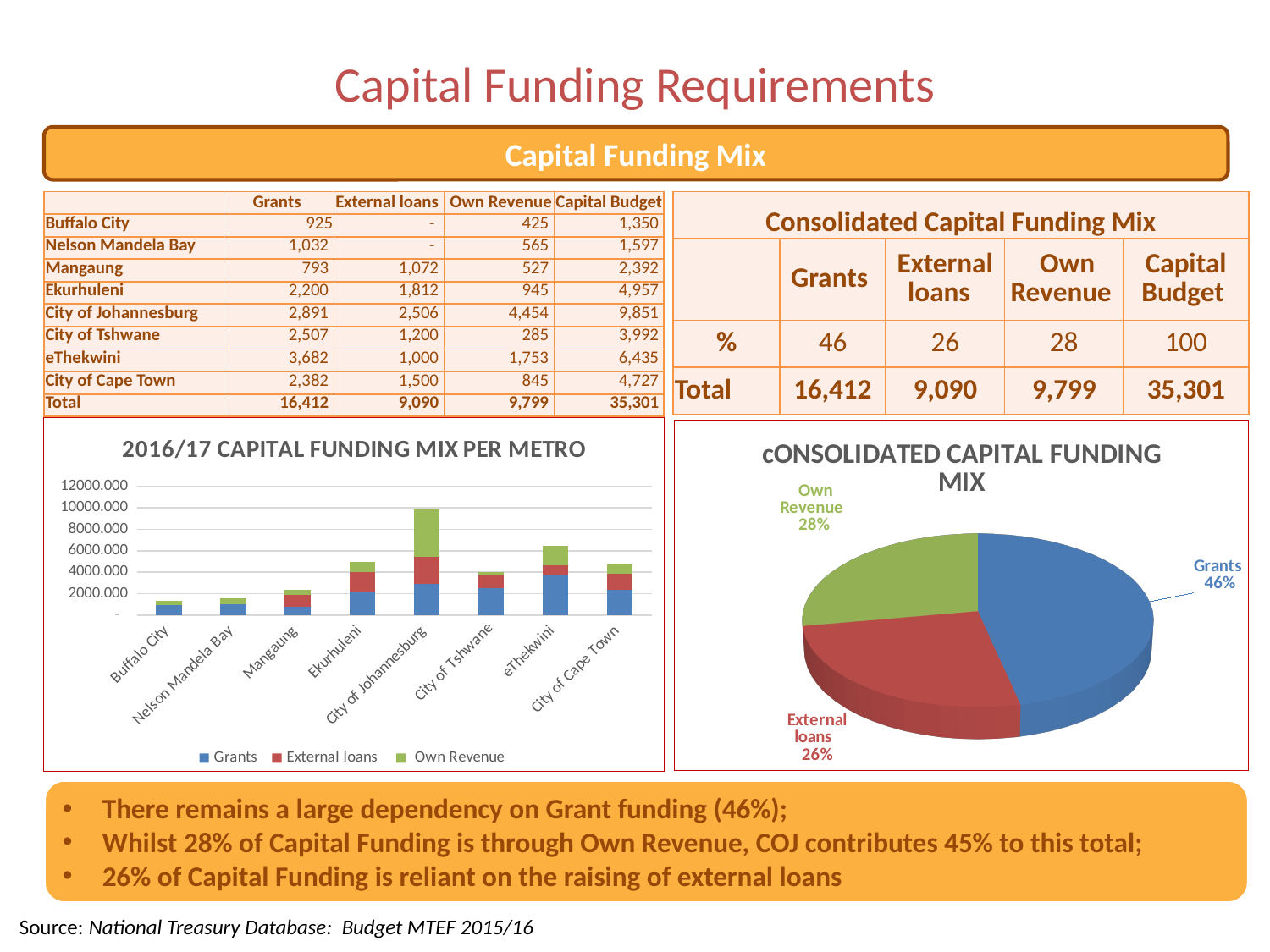
In the '2016/17 CAPITAL FUNDING MIX PER METRO' chart, how many metros are shown on the x axis? 8 In the '2016/17 CAPITAL FUNDING MIX PER METRO' chart, which metro has the shortest stacked bar? Buffalo City In the 'CONSOLIDATED CAPITAL FUNDING MIX' pie chart, which slice is the smallest? External loans How many series does the legend of the '2016/17 CAPITAL FUNDING MIX PER METRO' chart list? 3 In the 'CONSOLIDATED CAPITAL FUNDING MIX' pie chart, what share is labelled for Grants? 46% In the '2016/17 CAPITAL FUNDING MIX PER METRO' chart, is the total bar for City of Johannesburg greater or less than 8000? greater In the '2016/17 CAPITAL FUNDING MIX PER METRO' chart, which has the taller stacked bar, eThekwini or Ekurhuleni? eThekwini In the 'CONSOLIDATED CAPITAL FUNDING MIX' pie chart, how many percentage points larger is the Grants share than the Own Revenue share? 18 What kind of chart is the 'CONSOLIDATED CAPITAL FUNDING MIX' chart? Pie chart In the '2016/17 CAPITAL FUNDING MIX PER METRO' chart, which metro has the tallest stacked bar? City of Johannesburg In the '2016/17 CAPITAL FUNDING MIX PER METRO' chart, is the total bar for Mangaung greater or less than 4000? less What kind of chart is the '2016/17 CAPITAL FUNDING MIX PER METRO' chart? Stacked bar chart